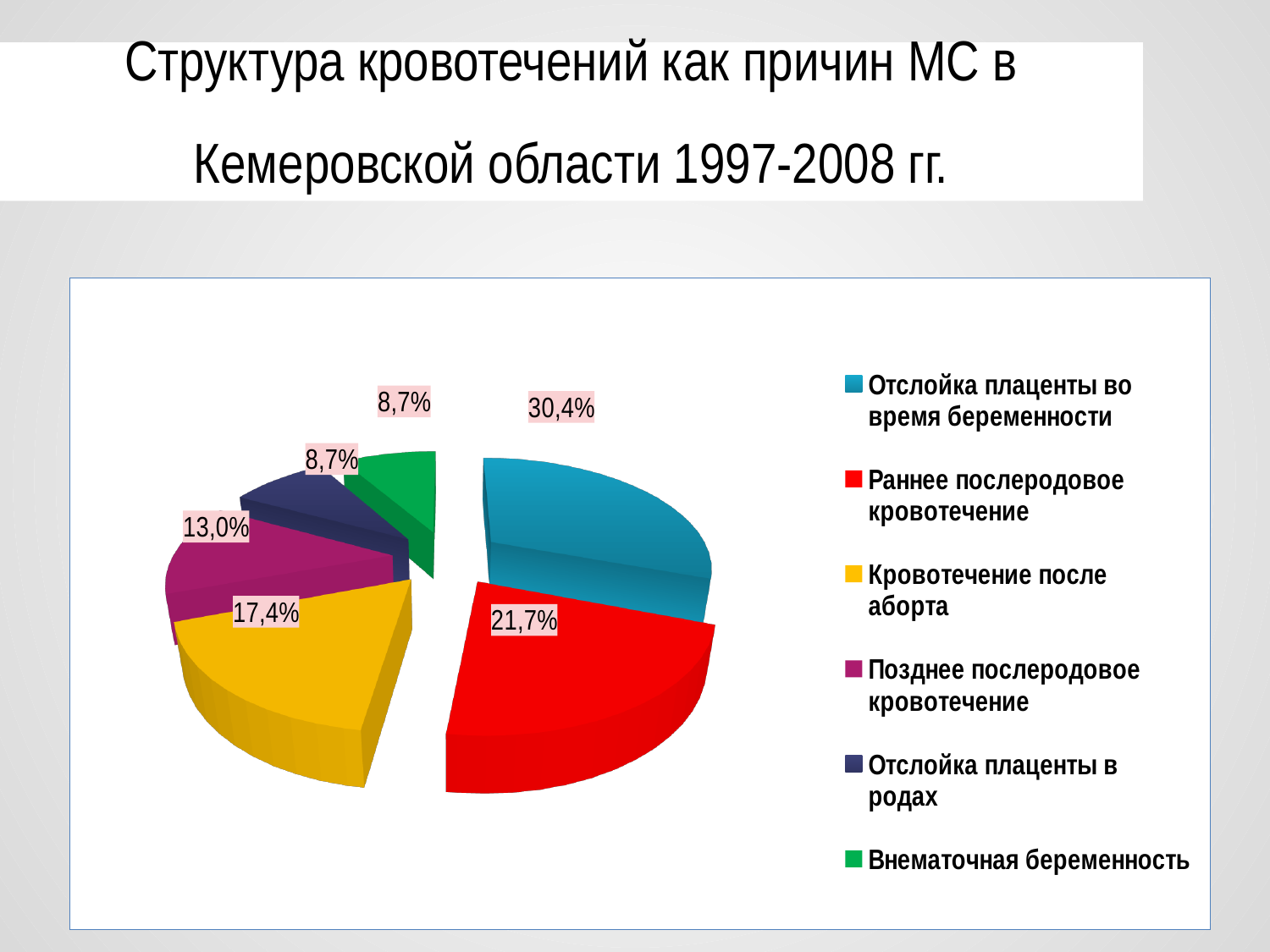
What share of the pie does "Внематочная беременность" have? 8,7% What is the difference between the shares of "Кровотечение после аборта" and "Отслойка плаценты в родах"? 8,7% What share of the pie does "Кровотечение после аборта" have? 17,4% What share of the pie does "Раннее послеродовое кровотечение" have? 21,7% What colour is the slice for "Раннее послеродовое кровотечение"? Red Which is larger: the share of "Кровотечение после аборта" or the share of "Позднее послеродовое кровотечение"? Кровотечение после аборта Which category has the largest slice of the pie? Отслойка плаценты во время беременности What kind of chart is shown on the slide? Pie chart How many categories does the pie chart show? 6 What is the difference between the shares of "Отслойка плаценты во время беременности" and "Раннее послеродовое кровотечение"? 8,7%